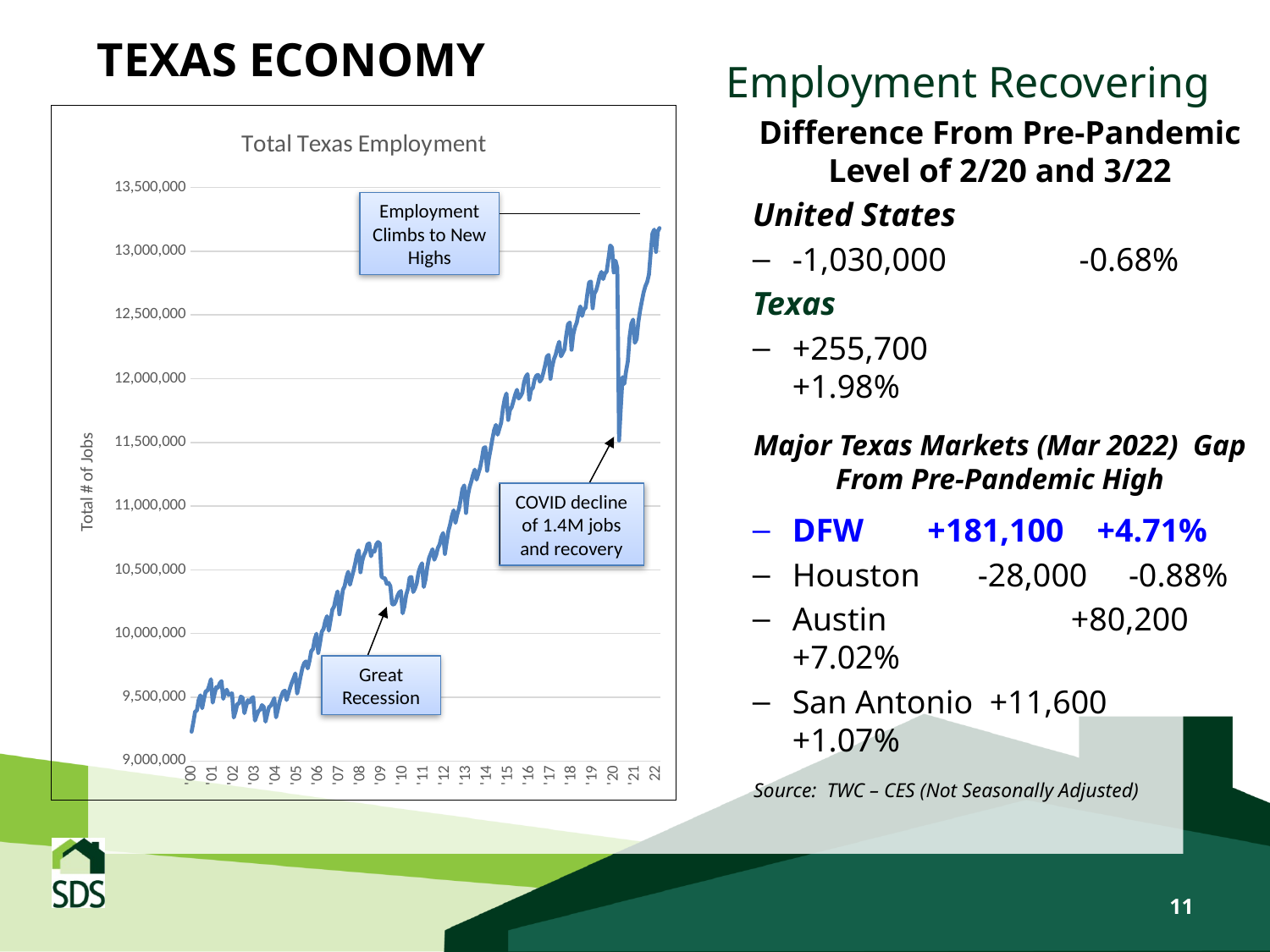
Is the value at the end of the chart in '22 greater or less than 13,000,000? greater Is the value in '04 greater or less than 10,000,000? less What label is shown on the vertical axis of the chart? Total # of Jobs How many year labels are shown along the x axis of the chart? 23 Which year label is the last one on the x axis of the chart? '22 Is the value in '19 greater or less than 12,500,000? greater Overall, do the values in the Total Texas Employment chart rise or fall from '00 to '22? Rise What kind of chart is shown on the slide? Line chart What is the title of the chart on the slide? Total Texas Employment